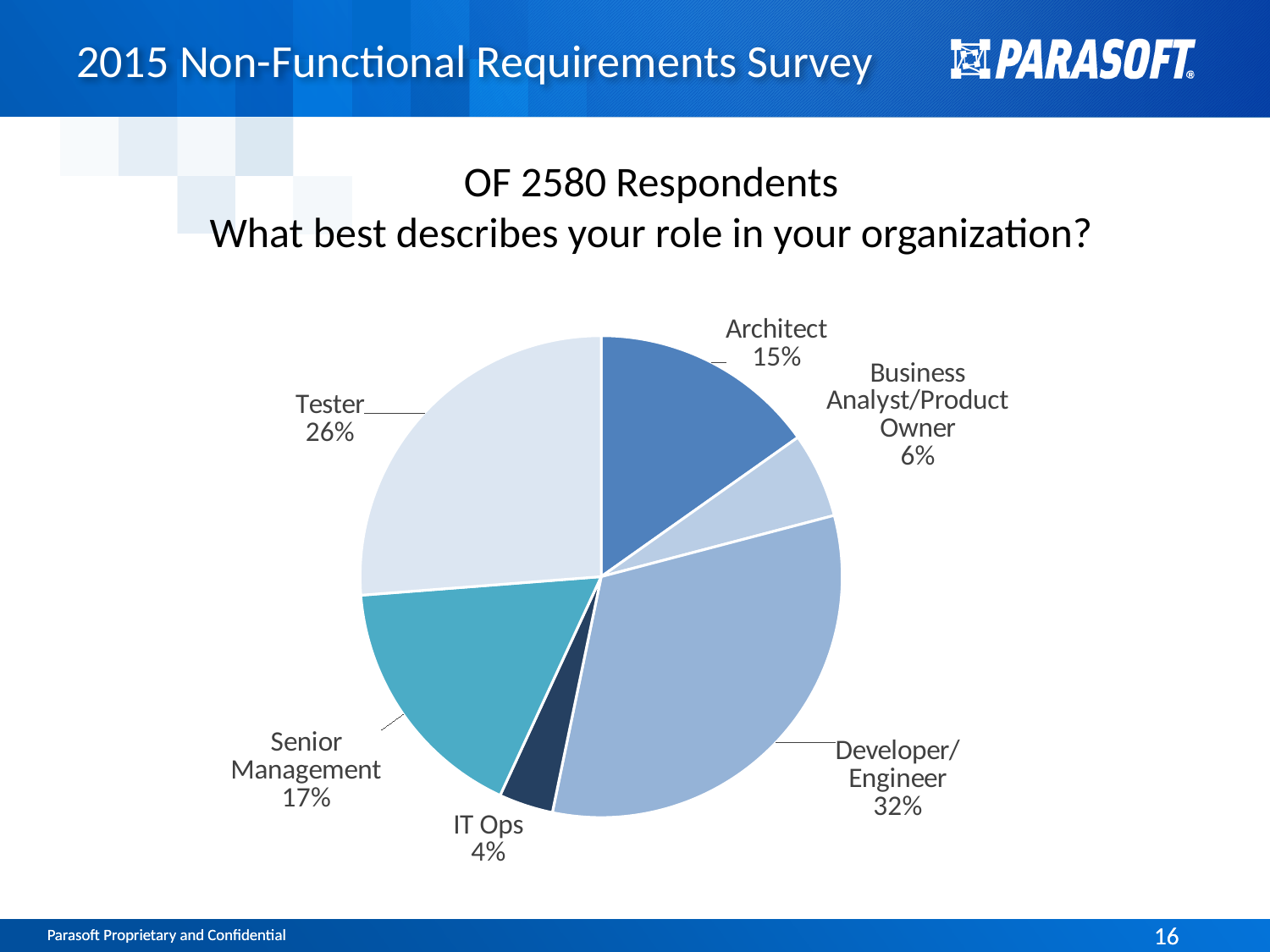
What percentage of respondents are Testers? 26% Which is larger, the share for IT Ops or the share for Business Analyst/Product Owner? Business Analyst/Product Owner How many respondents does the chart title say took part in the survey? 2580 What percentage of respondents are Architects? 15% Which is larger, the share for Senior Management or the share for Architect? Senior Management What is the difference in percentage points between Senior Management and Architect? 2 What type of chart is shown on the slide? Pie chart Which role has the largest share of respondents? Developer/Engineer What share of respondents are Business Analyst/Product Owner? 6% How many role categories are shown in the pie chart? 6 What is the difference in percentage points between Developer/Engineer and Tester? 6 Which role has the smallest share of respondents? IT Ops